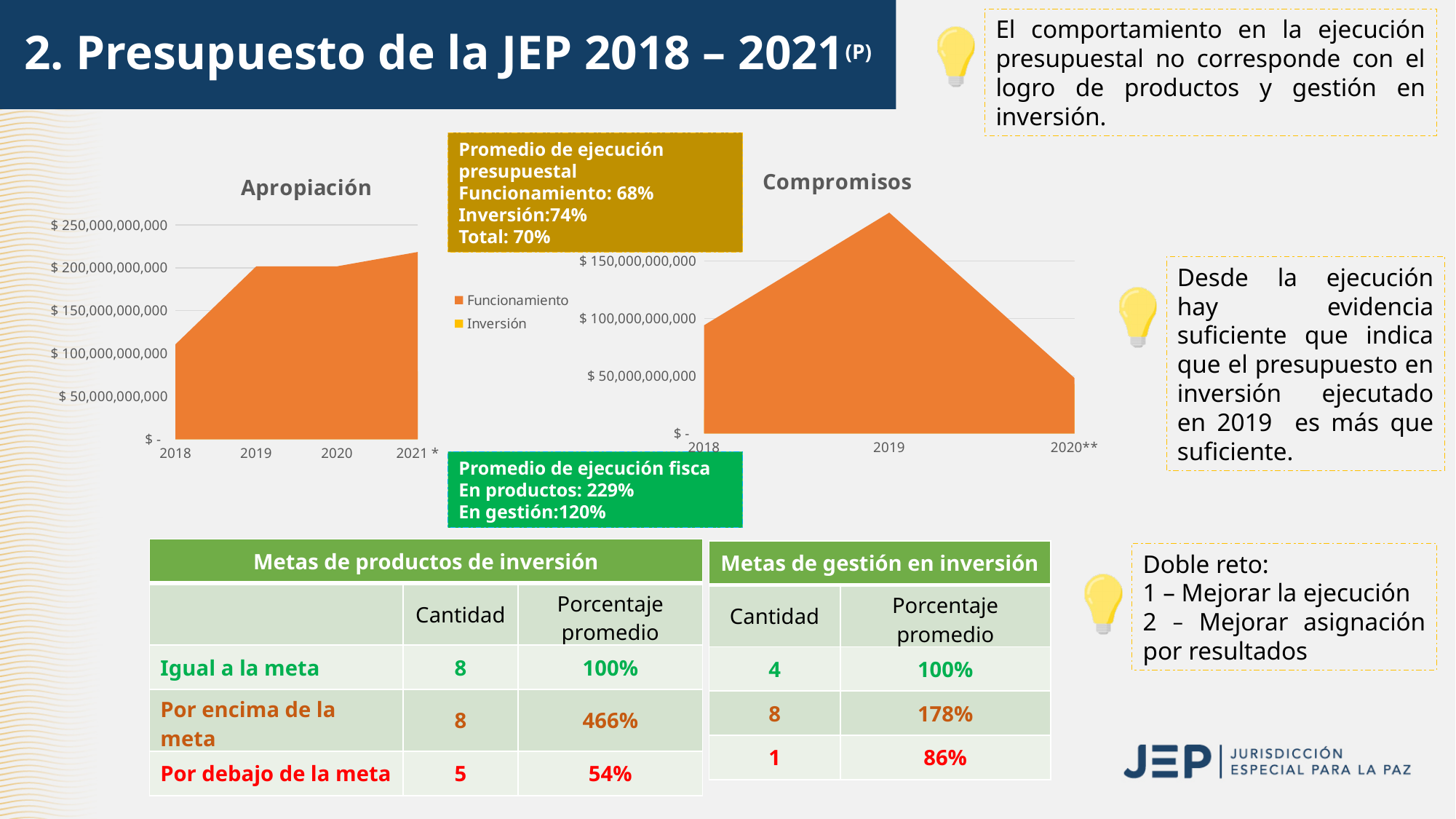
How many years are shown on the x axis of the Apropiación chart? 4 In the Apropiación chart, which year has the highest value? 2021 * In the Compromisos chart, which year has the lowest value? 2020** In the Compromisos chart, is the value for 2019 greater or less than $ 150,000,000,000? greater In the Apropiación chart, do the values generally rise or fall from 2018 to 2021 *? rise In the Compromisos chart, which year has the highest value? 2019 In the Apropiación chart, which year has the lowest value? 2018 In the Apropiación chart, is the value for 2021 * greater or less than $ 200,000,000,000? greater How many years are shown on the x axis of the Compromisos chart? 3 What kind of chart is the Apropiación chart? area chart In the Compromisos chart, is the value for 2020** greater or less than $ 100,000,000,000? less How many series does the legend between the two charts list? 2